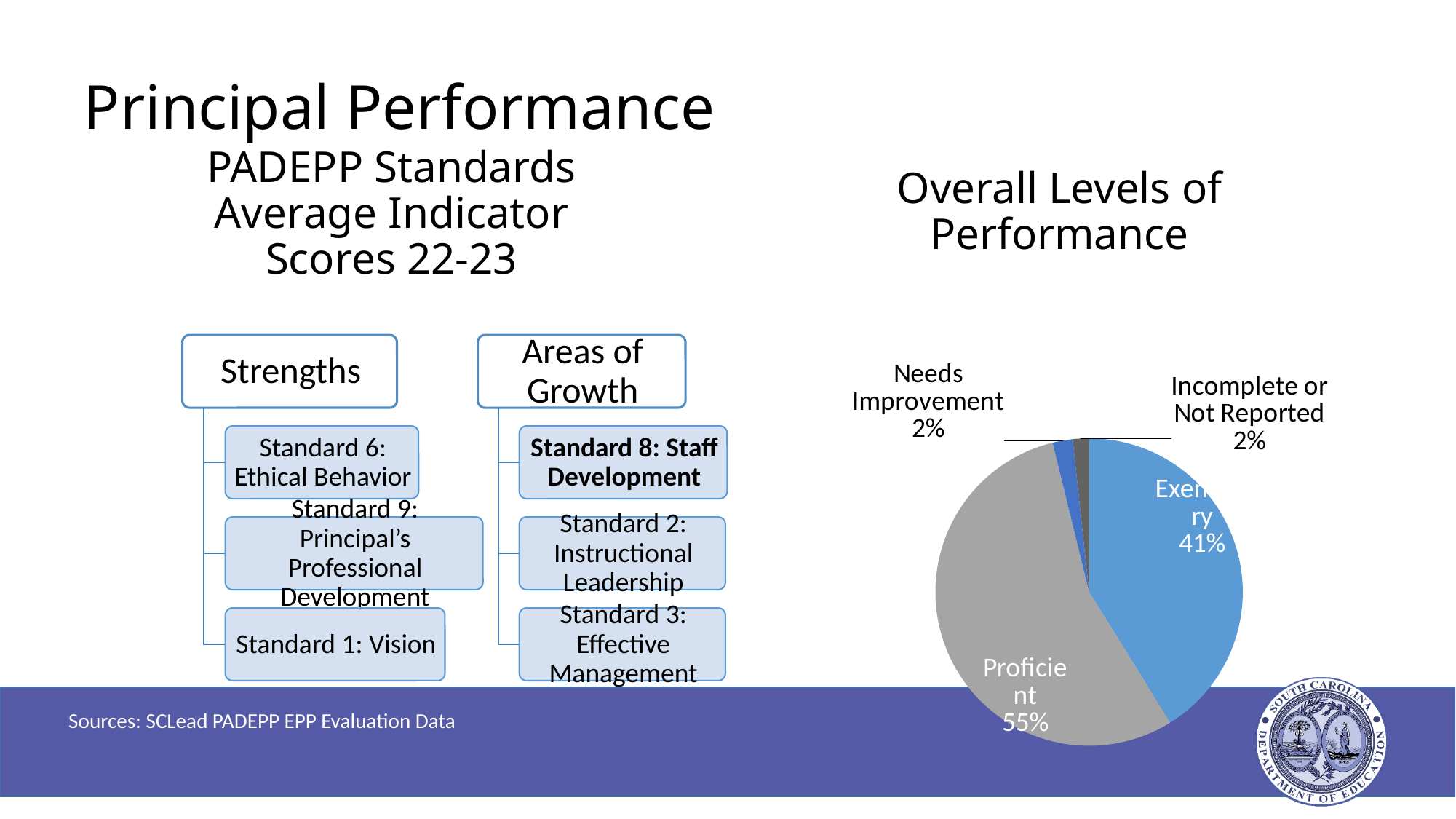
What type of chart is used to show Overall Levels of Performance? Pie chart In the Overall Levels of Performance pie chart, what is the combined share of the Proficient and Exemplary slices? 96% How many slices does the Overall Levels of Performance pie chart have? 4 What is the title of the chart on the right side of the slide? Overall Levels of Performance In the Overall Levels of Performance pie chart, what percentage is labelled Exemplary? 41% In the Overall Levels of Performance pie chart, how many percentage points larger is the Proficient share than the Exemplary share? 14 percentage points In the Overall Levels of Performance pie chart, which is larger: the Proficient slice or the Exemplary slice? Proficient In the Overall Levels of Performance pie chart, what percentage is labelled Incomplete or Not Reported? 2% In the Overall Levels of Performance pie chart, is the Proficient share greater or less than 50%? greater In the Overall Levels of Performance pie chart, what percentage of principals are rated Proficient? 55% In the Overall Levels of Performance pie chart, what percentage is labelled Needs Improvement? 2% Which category has the largest slice in the Overall Levels of Performance pie chart? Proficient